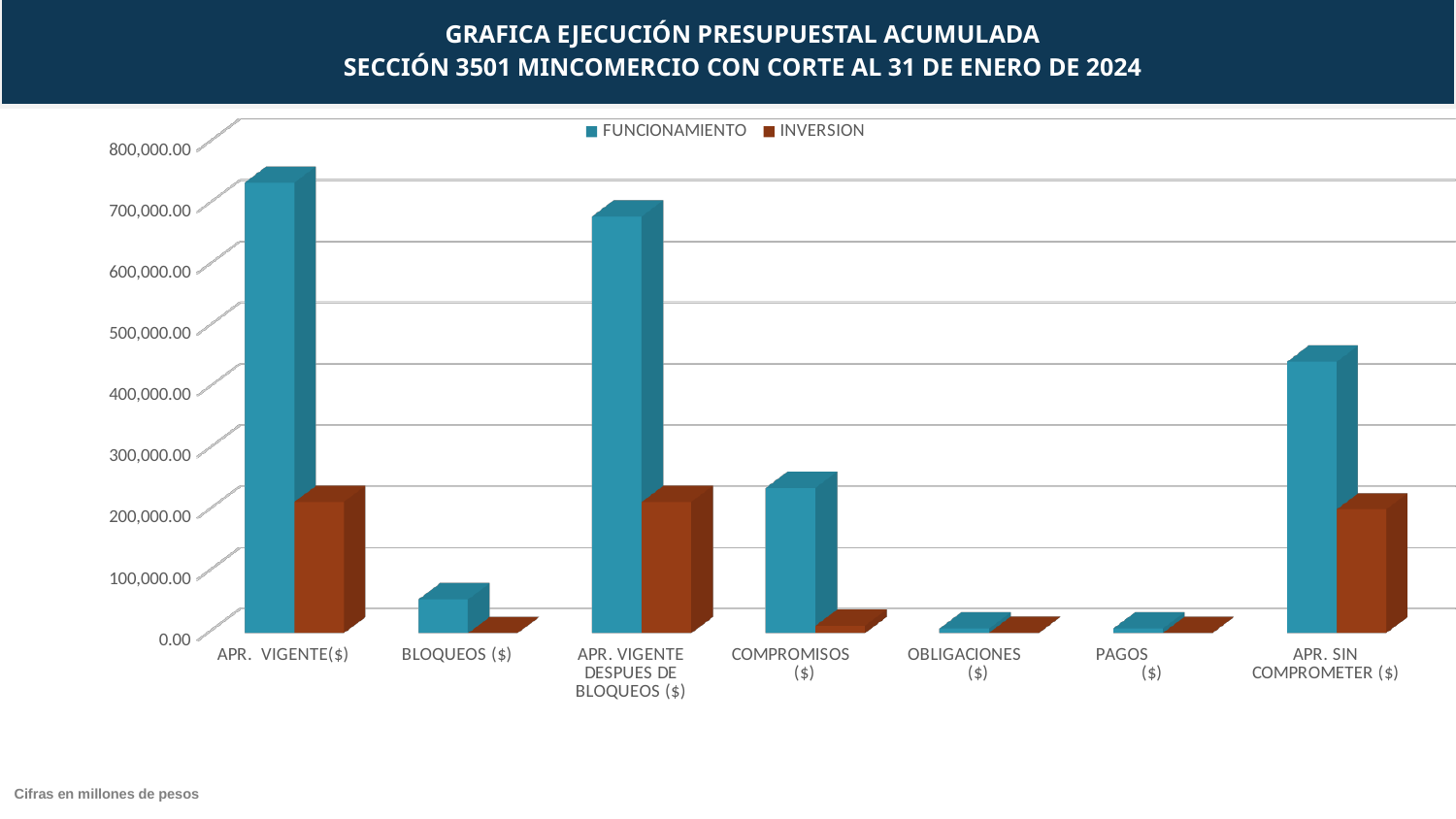
Is the INVERSION value for APR. VIGENTE($) greater or less than 300,000.00? less Is the INVERSION value for COMPROMISOS ($) greater or less than 100,000.00? less How many series does the legend list? 2 Is the FUNCIONAMIENTO value for BLOQUEOS ($) greater or less than 100,000.00? less How many categories are shown on the x axis? 7 What kind of chart is shown on the slide? bar chart For APR. VIGENTE($), which series has the larger value, FUNCIONAMIENTO or INVERSION? FUNCIONAMIENTO Which category has the highest FUNCIONAMIENTO value? APR. VIGENTE($) Which series is shown in blue in the legend? FUNCIONAMIENTO For the FUNCIONAMIENTO series, which is larger: APR. VIGENTE($) or APR. SIN COMPROMETER ($)? APR. VIGENTE($)